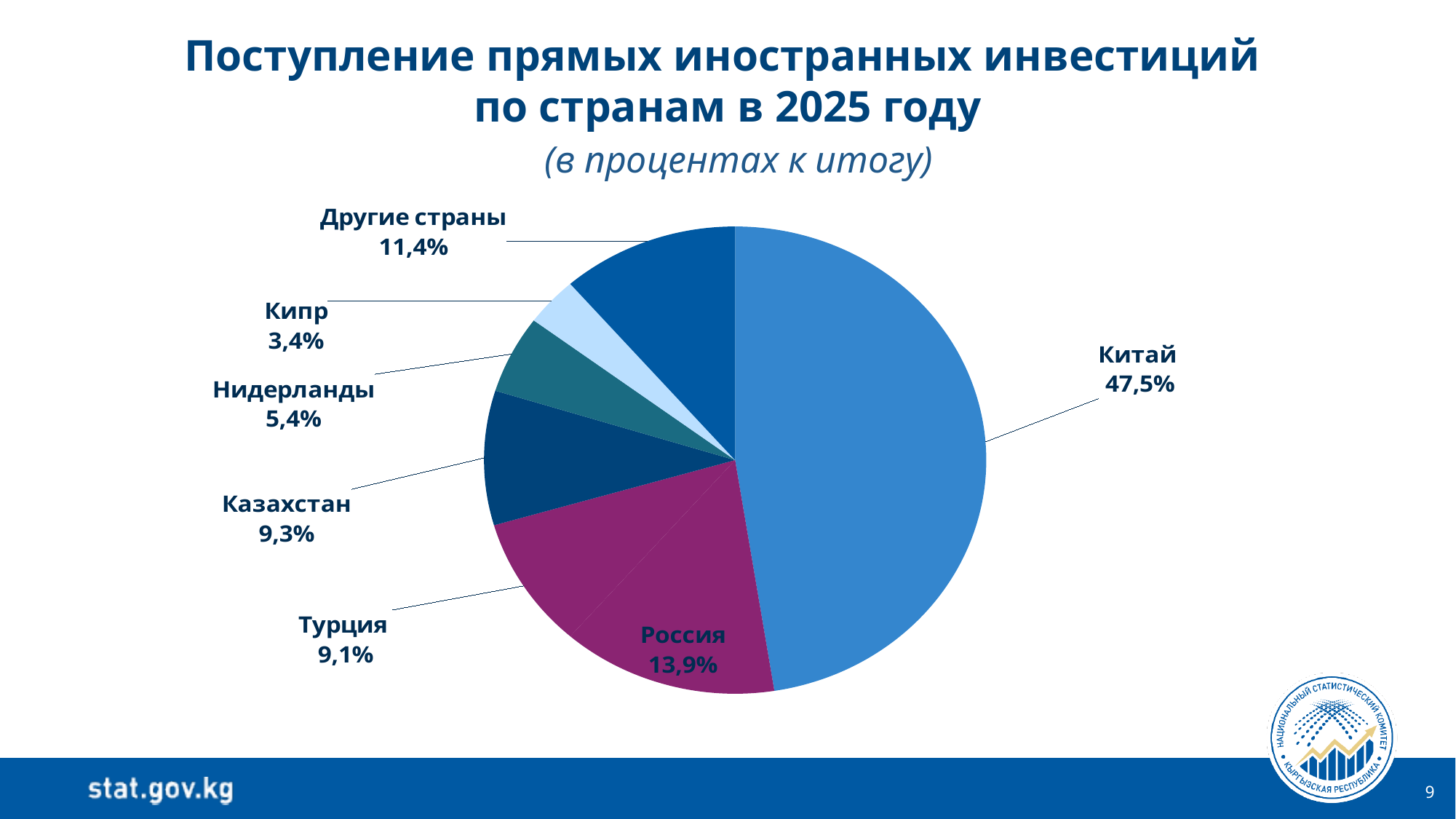
What type of chart is shown on the slide? Pie chart Which category has the smallest slice of the pie? Кипр Which country has the largest slice of the pie? Китай What percentage is shown for Казахстан (Kazakhstan)? 9,3% What share of foreign direct investment inflows does Китай (China) account for? 47,5% Which is larger, the share of Турция or the share of Нидерланды? Турция What is the value shown for Россия (Russia)? 13,9% What is the difference between the shares of Другие страны and Нидерланды? 6,0% What is the share for Кипр (Cyprus)? 3,4% How many slices does the pie chart have? 7 What is the title of the chart? Поступление прямых иностранных инвестиций по странам в 2025 году What is the difference between the shares of Китай and Россия? 33,6%